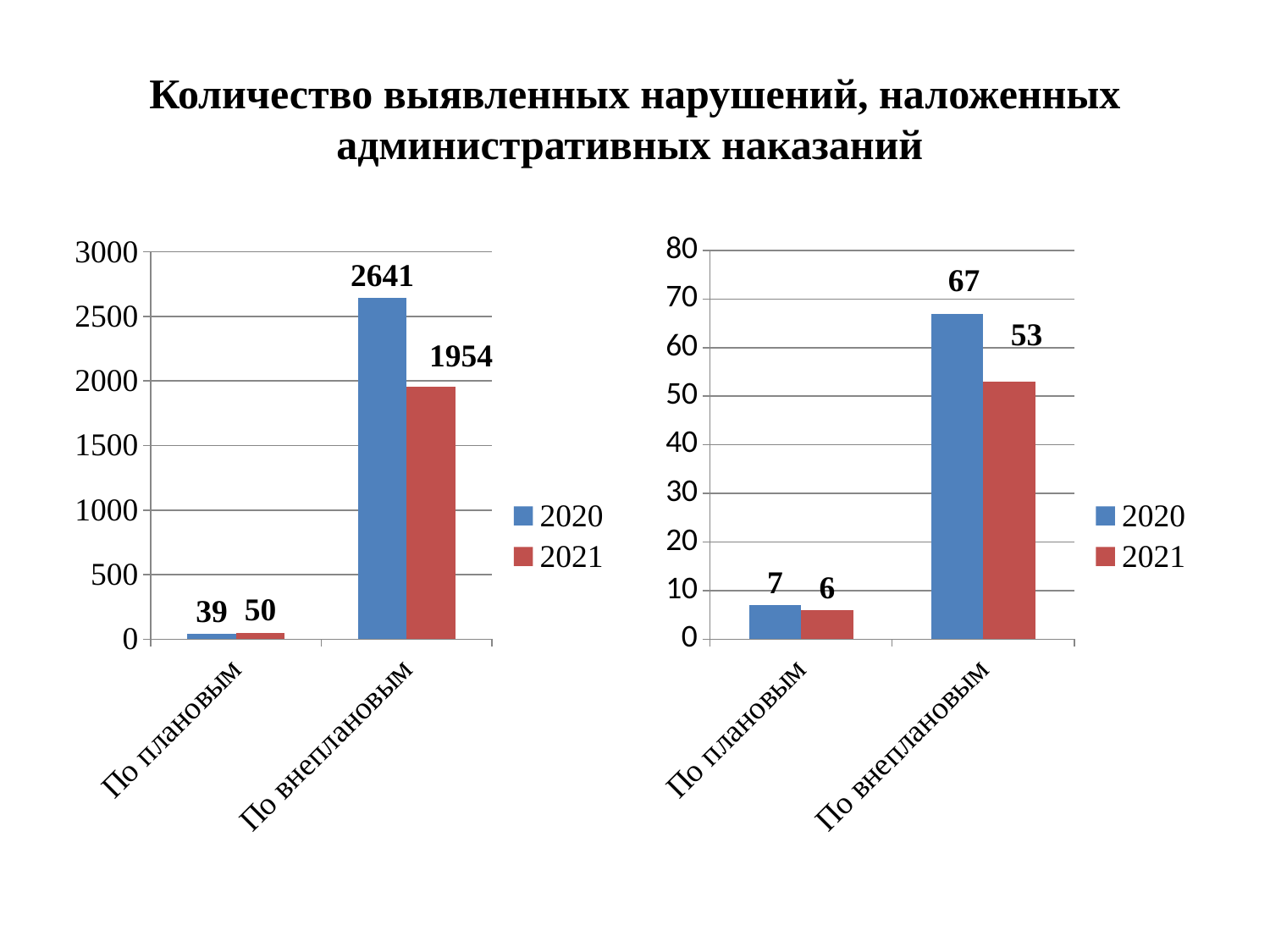
In the left chart, what is the value for 2021 for По плановым? 50 In the right chart, what is the difference between the 2020 and 2021 values for По внеплановым? 14 What kind of chart is the right chart? Bar chart How many categories are shown on the x axis of the left chart? 2 In the left chart, what is the value for 2020 for По внеплановым? 2641 In the left chart, what is the difference between the 2020 and 2021 values for По внеплановым? 687 In the right chart, which category has the highest value for 2020? По внеплановым In the right chart, which category has the lowest value for 2021? По плановым In the left chart, which is larger for По плановым: the 2020 value or the 2021 value? 2021 In the right chart, what is the value for 2020 for По плановым? 7 How many series does the legend of the left chart list? 2 In the right chart, what is the value for 2021 for По внеплановым? 53